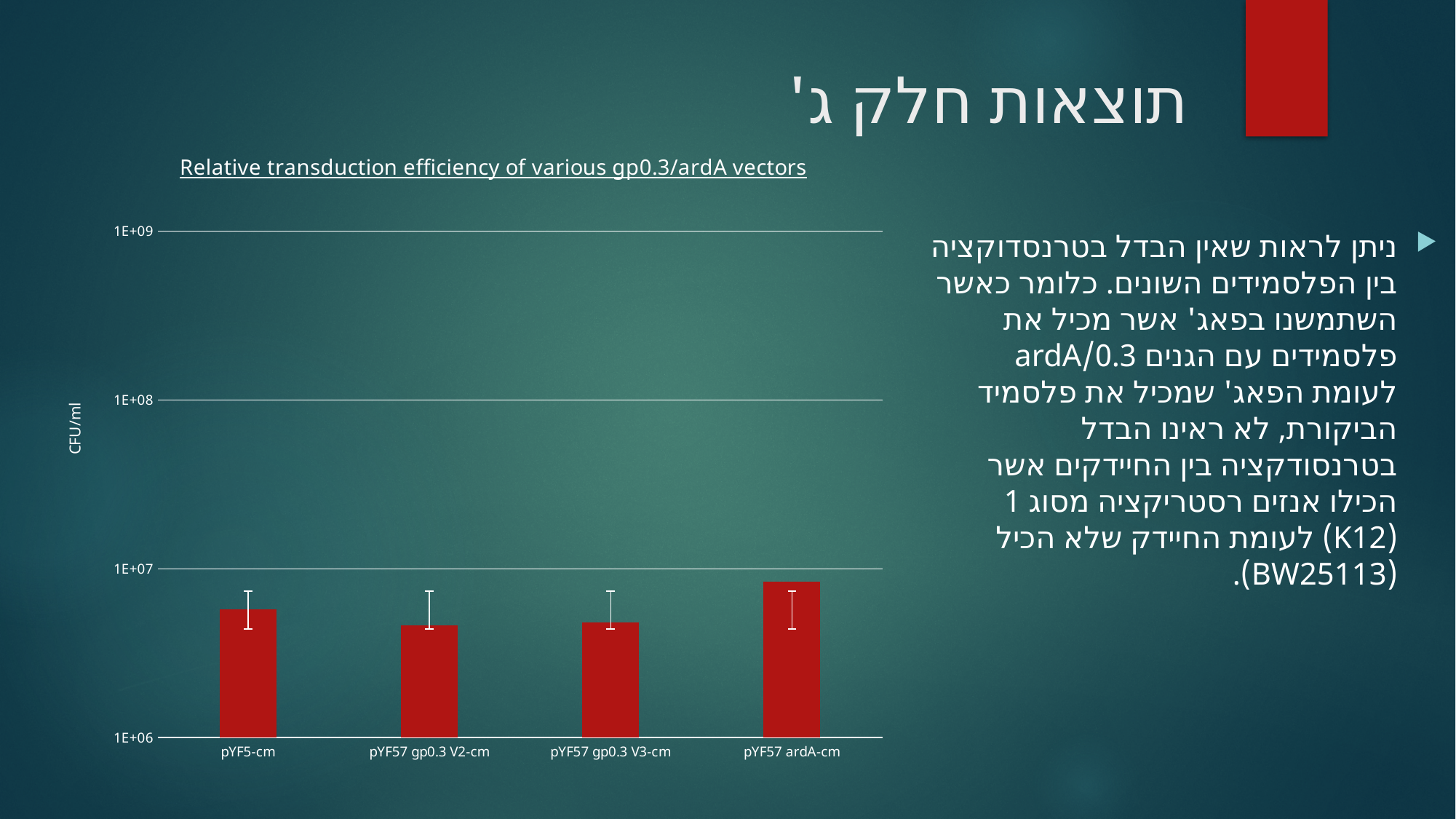
Which is larger, the value for pYF57 ardA-cm or the value for pYF57 gp0.3 V2-cm? pYF57 ardA-cm What is the highest tick value shown on the y axis of the chart? 1E+09 What is the title of the chart? Relative transduction efficiency of various gp0.3/ardA vectors Which vector has the highest transduction efficiency in the chart? pYF57 ardA-cm Which is larger, the value for pYF5-cm or the value for pYF57 gp0.3 V3-cm? pYF5-cm Is the value for pYF57 ardA-cm greater or less than 1E+07? less What kind of chart is shown on the slide? bar chart What is the label of the y axis of the chart? CFU/ml Is the value for pYF57 gp0.3 V2-cm greater or less than 1E+06? greater Is the value for pYF5-cm greater or less than 1E+07? less How many categories (vectors) are plotted on the x axis of the chart? 4